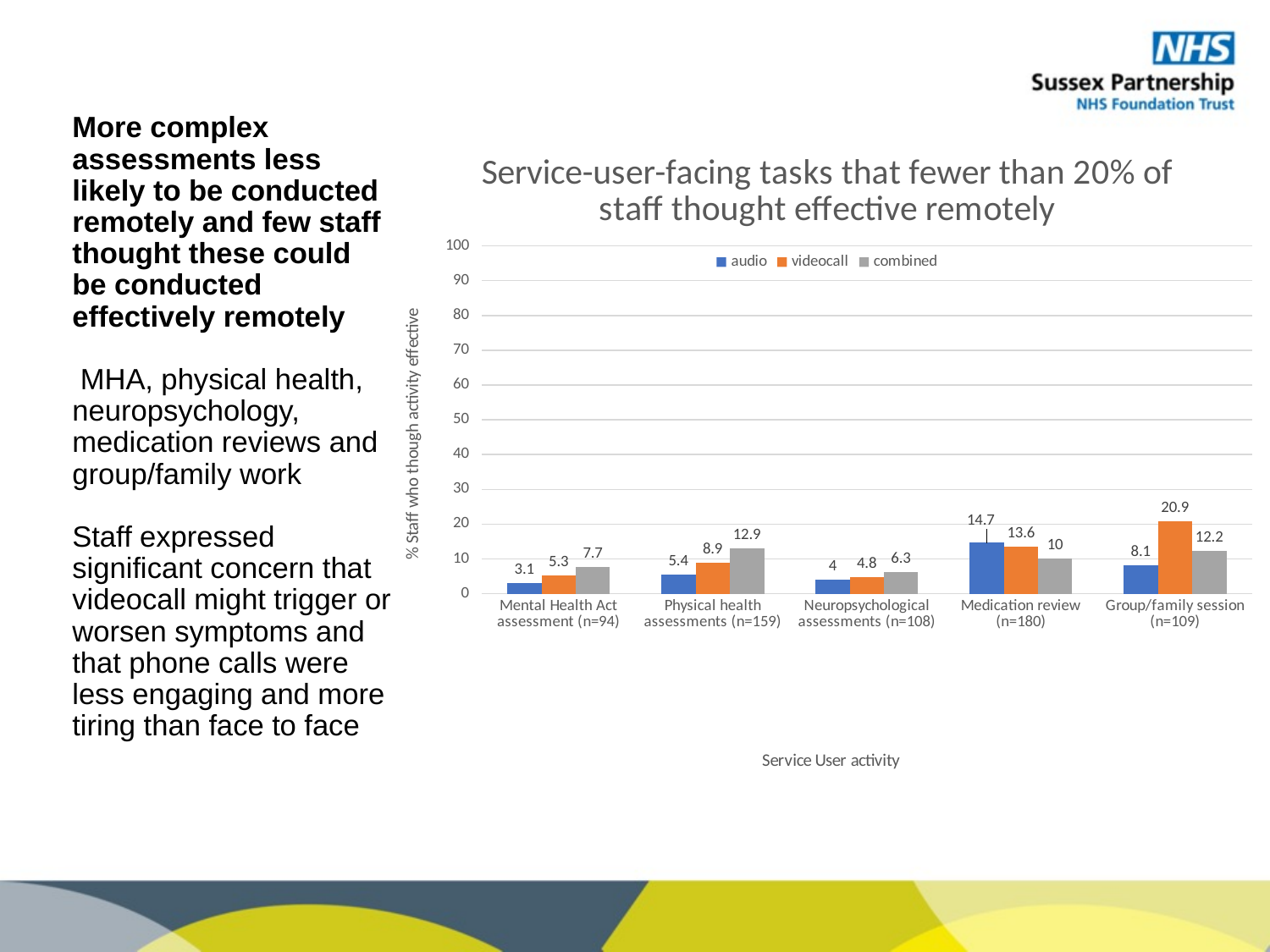
What is the difference between the videocall and audio values for Group/family session (n=109)? 12.8 What is the videocall value for Group/family session (n=109)? 20.9 Is the videocall value for Group/family session (n=109) greater or less than 20? greater Which category has the lowest audio value? Mental Health Act assessment (n=94) What type of chart is shown on the slide? bar chart Which category has the highest videocall value? Group/family session (n=109) What is the audio value for Medication review (n=180)? 14.7 What is the combined value for Physical health assessments (n=159)? 12.9 Which is larger for Medication review (n=180): the audio value or the combined value? audio How many series does the legend list? 3 What is the audio value for Neuropsychological assessments (n=108)? 4 How many service user activity categories are shown on the x axis? 5